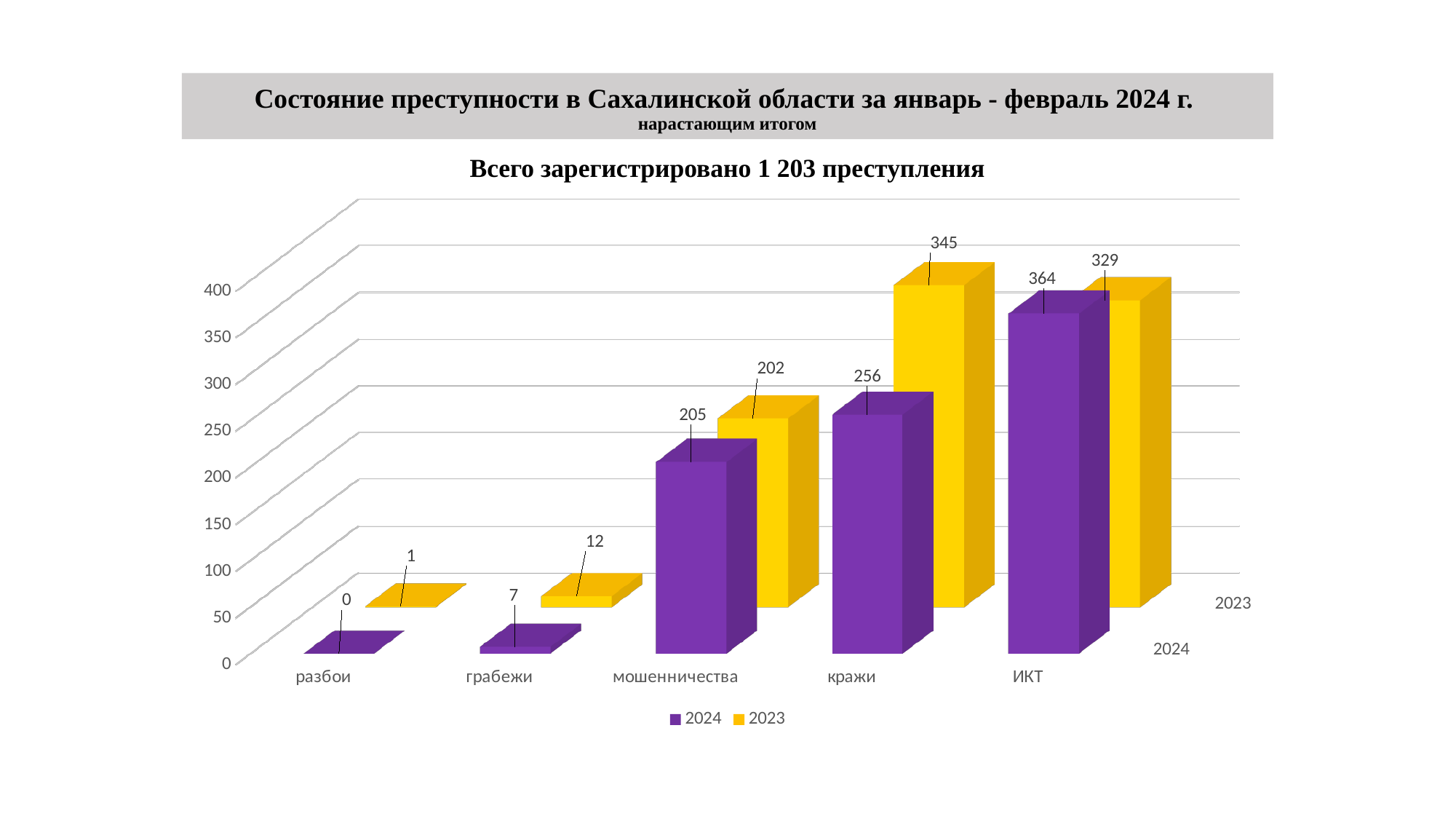
Which category has the highest value in the 2023 series? кражи What is the total number of crimes stated in the chart title? 1 203 How many series does the legend list? 2 What is the value for грабежи in the 2023 series? 12 What is the value for мошенничества in the 2023 series? 202 What is the difference between the 2023 and 2024 values for кражи? 89 What is the value for ИКТ in the 2024 series? 364 What kind of chart is shown on the slide? bar chart Which is larger for ИКТ: the 2024 value or the 2023 value? 2024 What is the value for кражи in the 2024 series? 256 How many categories are shown on the x axis? 5 Which category has the lowest value in the 2024 series? разбои